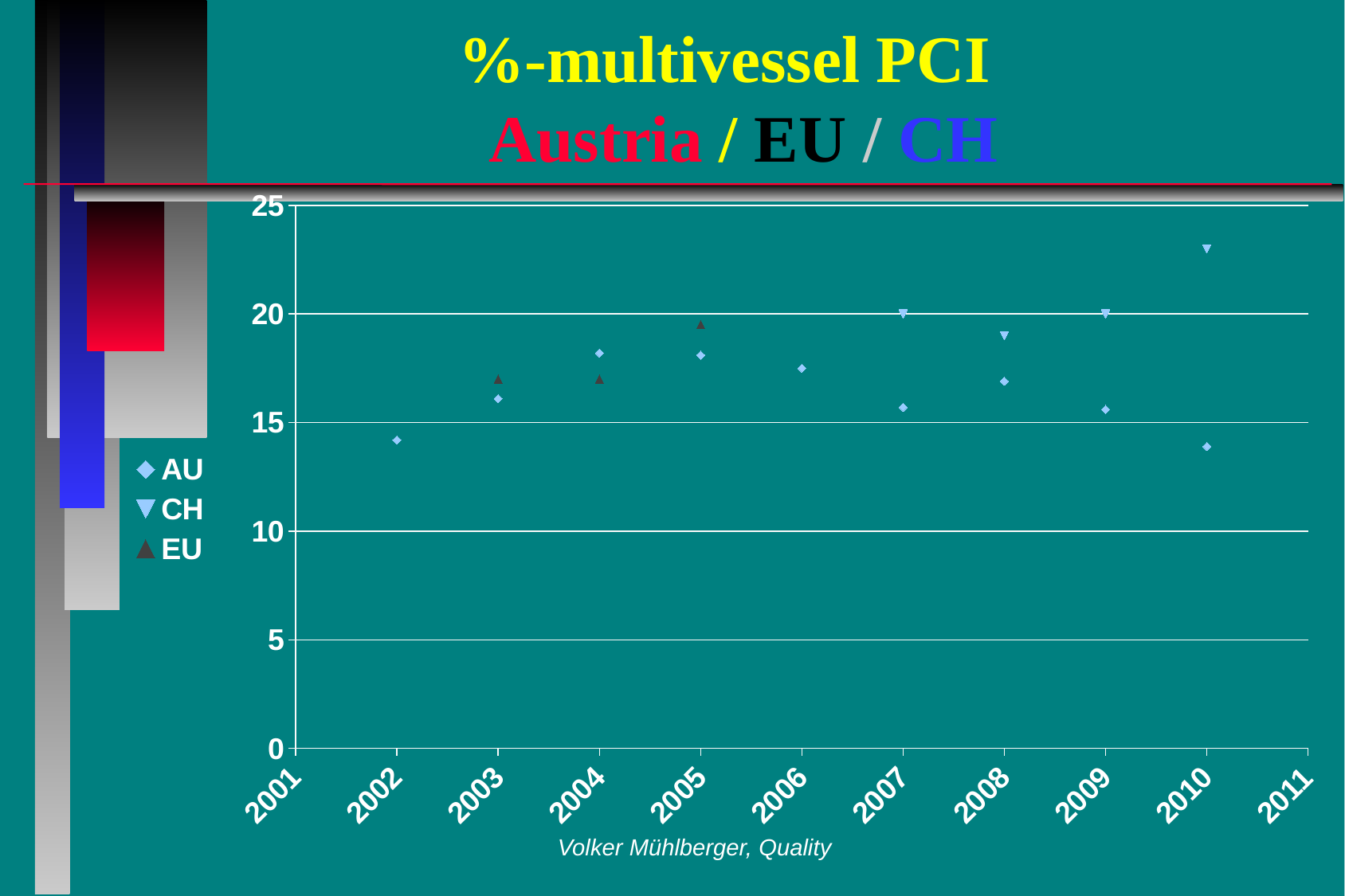
What is the title of the chart? %-multivessel PCI Austria / EU / CH Is the value for AU in 2004 greater or less than 15? greater Is the value for AU in 2002 greater or less than 15? less What kind of chart is shown on the slide? scatter chart In 2005, which series has the larger value, EU or AU? EU Is the value for EU in 2005 greater or less than 20? less How many data points are plotted for the CH series? 4 Which series are listed in the legend? AU, CH, EU In which year does the CH series reach its highest value? 2010 How many series does the legend list? 3 In 2010, which series has the larger value, CH or AU? CH